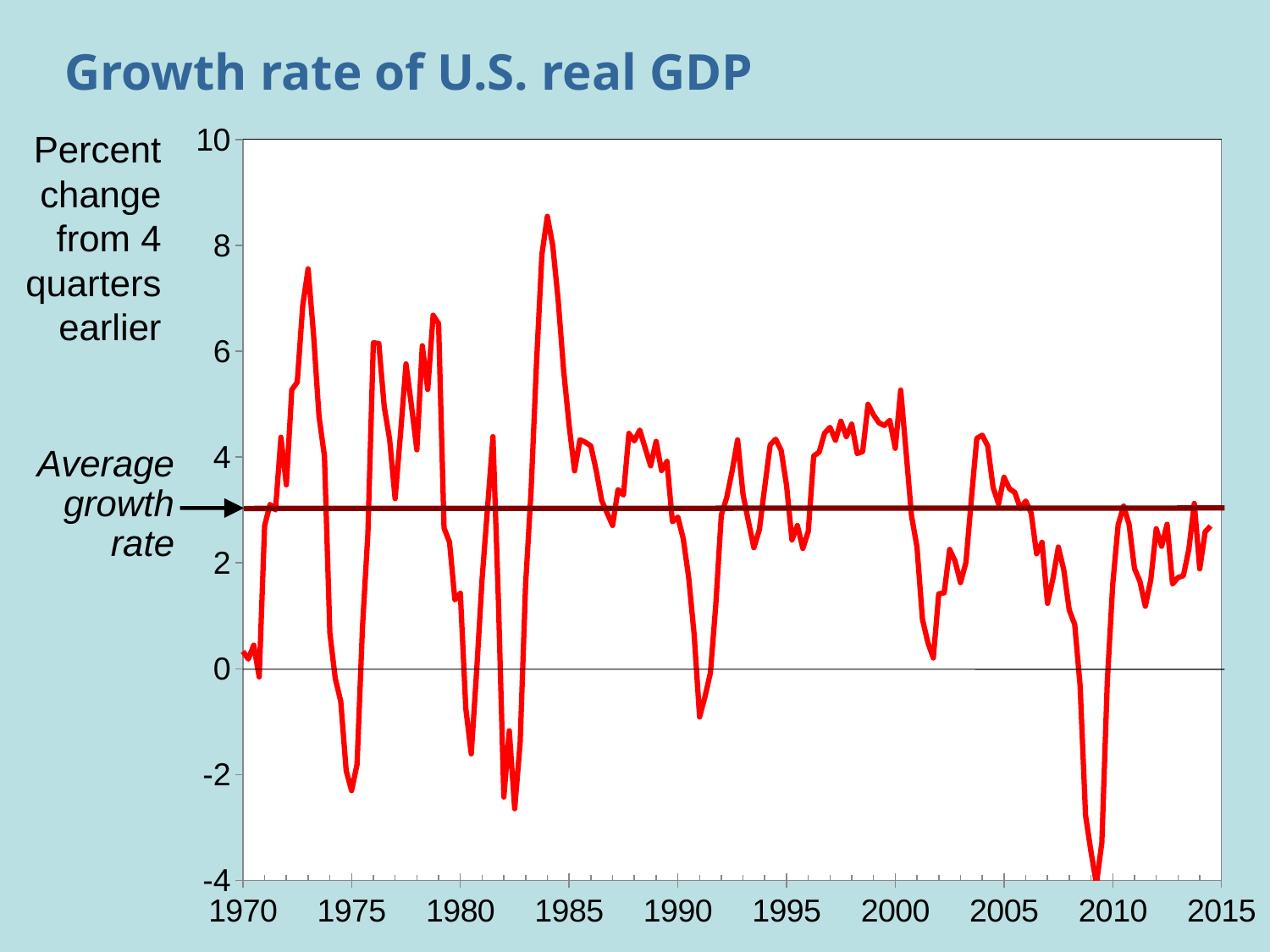
Is the growth rate in 1970 greater or less than 2? less Is the peak of the growth rate line around 1984 greater or less than 8? greater Is the growth rate around 1991 greater or less than 0? less What kind of chart is shown on the slide? line chart What is the title of the chart? Growth rate of U.S. real GDP What does the label on the left of the chart say the vertical axis measures? Percent change from 4 quarters earlier